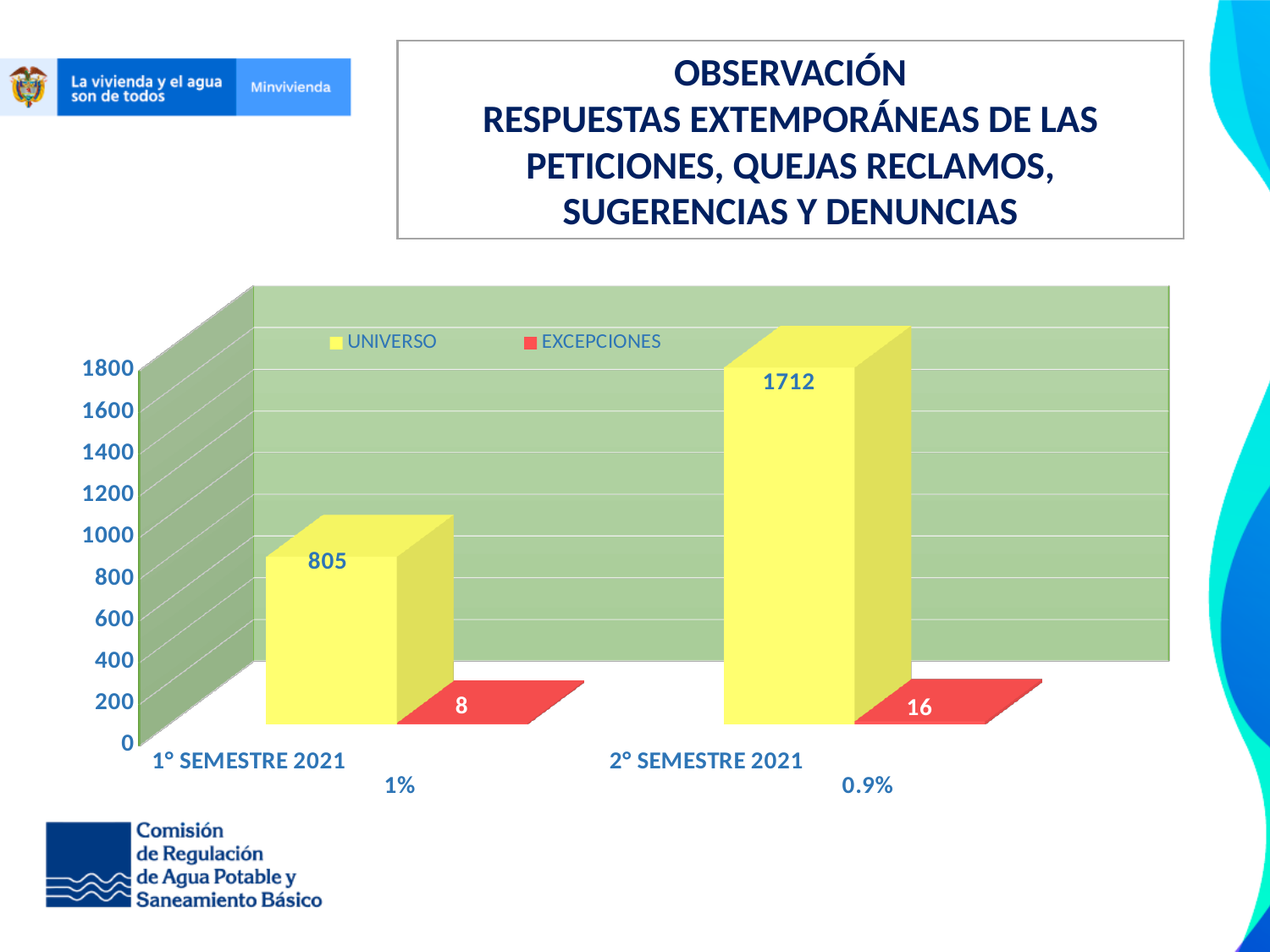
What is the EXCEPCIONES value for 1° SEMESTRE 2021? 8 What kind of chart is shown on the slide? bar chart How many series does the legend list? 2 Which semester has the higher UNIVERSO value? 2° SEMESTRE 2021 Is the UNIVERSO value for 1° SEMESTRE 2021 greater or less than 1000? less What is the UNIVERSO value for 1° SEMESTRE 2021? 805 What is the difference between the EXCEPCIONES values for 2° SEMESTRE 2021 and 1° SEMESTRE 2021? 8 What is the difference between the UNIVERSO values for 2° SEMESTRE 2021 and 1° SEMESTRE 2021? 907 What is the EXCEPCIONES value for 2° SEMESTRE 2021? 16 What is the UNIVERSO value for 2° SEMESTRE 2021? 1712 Which semester has the lower EXCEPCIONES value? 1° SEMESTRE 2021 What percentage is shown below 2° SEMESTRE 2021? 0.9%